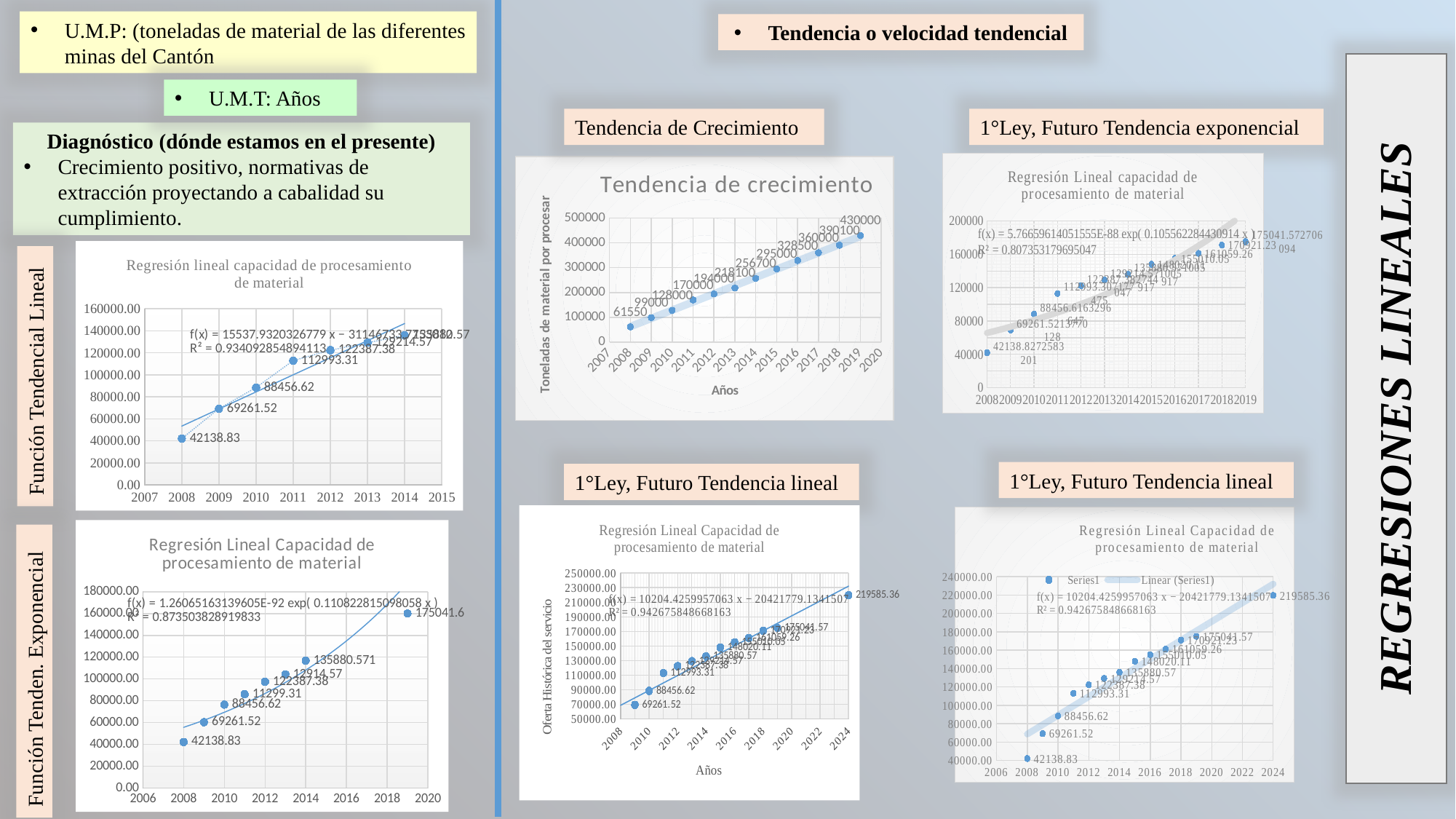
In the 'Tendencia de crecimiento' chart, which year has the lowest value? 2008 In the 'Tendencia de crecimiento' chart, what is the value for 2015? 295000 In the bottom-right chart (1°Ley, Futuro Tendencia lineal), how many entries does the legend list? 2 In the 'Tendencia de crecimiento' chart, what is the difference between the 2019 value and the 2008 value? 368450 In the 'Tendencia de crecimiento' chart, what is the value for 2019? 430000 In the top-left chart (Función Tendencial Lineal), what is the difference between the 2009 value and the 2008 value? 27122.69 In the 'Tendencia de crecimiento' chart, how many data points are plotted? 12 In the 'Tendencia de crecimiento' chart, do the values rise or fall from 2008 to 2019? rise In the 'Tendencia de crecimiento' chart, which year has the highest value? 2019 In the 'Tendencia de crecimiento' chart, what is the value for 2008? 61550 In the top-left chart (Función Tendencial Lineal), what is the value for 2008? 42138.83 In the 'Tendencia de crecimiento' chart, what is the label of the vertical axis? Toneladas de material por procesar